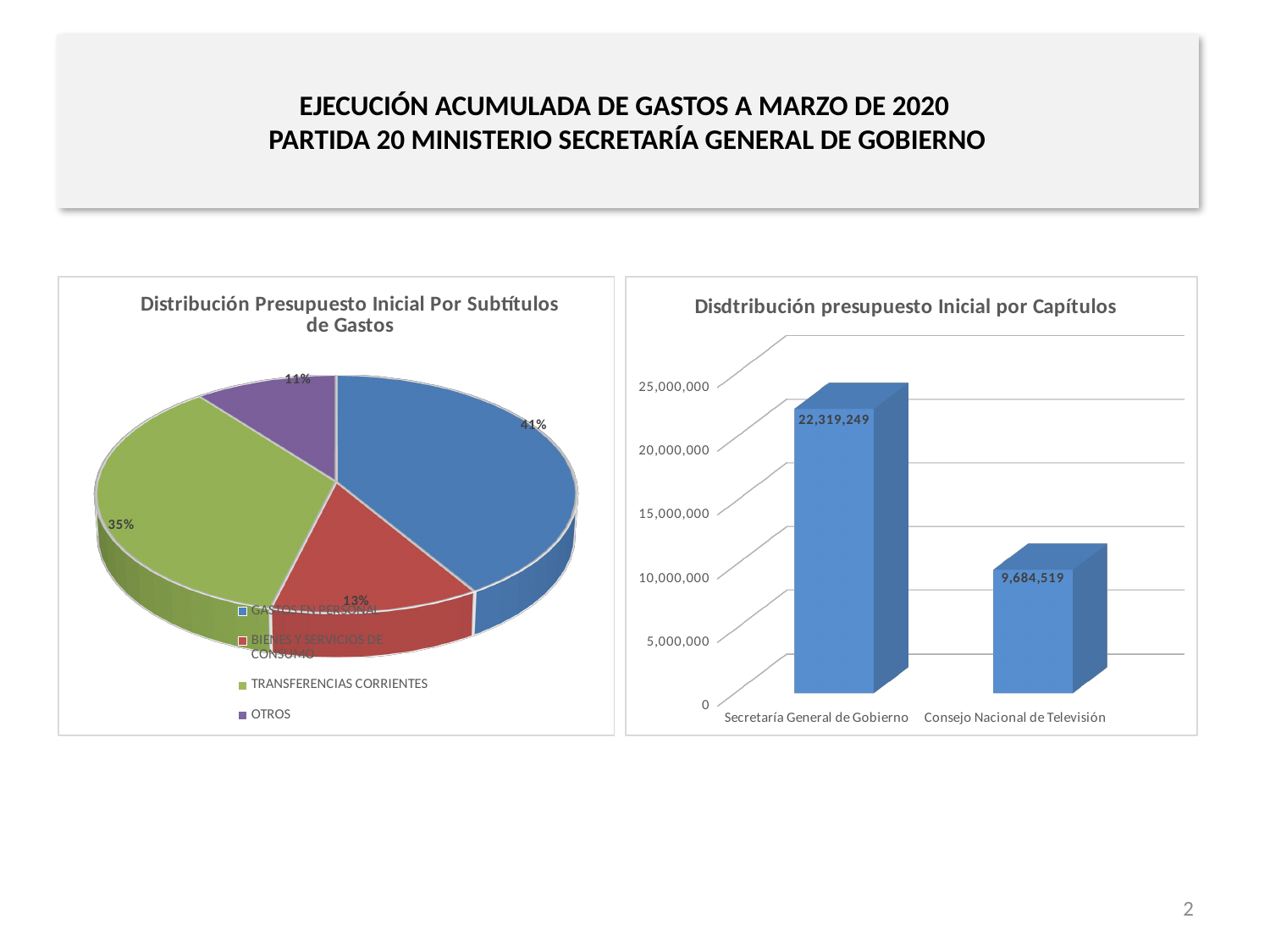
In the pie chart 'Distribución Presupuesto Inicial Por Subtítulos de Gastos', which category has the smallest share? OTROS In the bar chart 'Disdtribución presupuesto Inicial por Capítulos', what is the value for Secretaría General de Gobierno? 22,319,249 In the bar chart 'Disdtribución presupuesto Inicial por Capítulos', is the value for Consejo Nacional de Televisión greater or less than 10,000,000? less In the pie chart 'Distribución Presupuesto Inicial Por Subtítulos de Gastos', which category has the largest share? GASTOS EN PERSONAL In the pie chart 'Distribución Presupuesto Inicial Por Subtítulos de Gastos', what share does OTROS have? 11% In the pie chart 'Distribución Presupuesto Inicial Por Subtítulos de Gastos', what is the difference in percentage points between GASTOS EN PERSONAL and TRANSFERENCIAS CORRIENTES? 6 percentage points What kind of chart is the chart on the right of the slide? Bar chart In the bar chart 'Disdtribución presupuesto Inicial por Capítulos', what is the value for Consejo Nacional de Televisión? 9,684,519 In the pie chart 'Distribución Presupuesto Inicial Por Subtítulos de Gastos', which colour represents TRANSFERENCIAS CORRIENTES? Green In the pie chart 'Distribución Presupuesto Inicial Por Subtítulos de Gastos', what share does TRANSFERENCIAS CORRIENTES have? 35% In the bar chart 'Disdtribución presupuesto Inicial por Capítulos', what is the difference between Secretaría General de Gobierno and Consejo Nacional de Televisión? 12,634,730 In the pie chart 'Distribución Presupuesto Inicial Por Subtítulos de Gastos', how many slices are there? 4